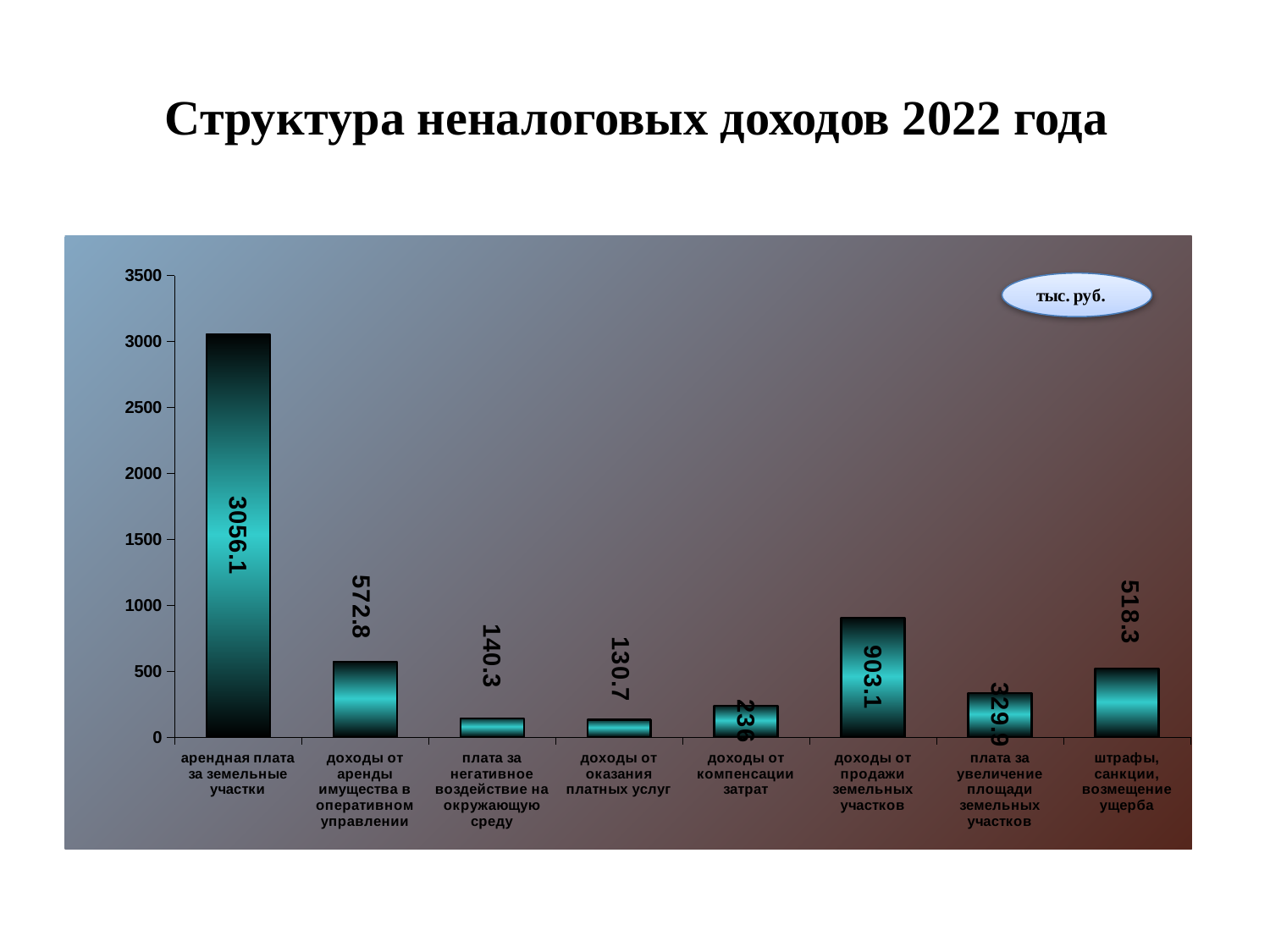
What unit is indicated in the label at the top right of the chart? тыс. руб. How many categories are shown on the chart? 8 What is the value for штрафы, санкции, возмещение ущерба? 518.3 Which category has the highest value? арендная плата за земельные участки What is the value for доходы от компенсации затрат? 236 What is the value for арендная плата за земельные участки? 3056.1 What is the difference between the values for доходы от аренды имущества в оперативном управлении and плата за негативное воздействие на окружающую среду? 432.5 What is the value for доходы от продажи земельных участков? 903.1 Is the value for плата за увеличение площади земельных участков greater or less than 500? less Which category has the lowest value? доходы от оказания платных услуг Which is larger: доходы от продажи земельных участков or штрафы, санкции, возмещение ущерба? доходы от продажи земельных участков What kind of chart is shown on the slide? bar chart